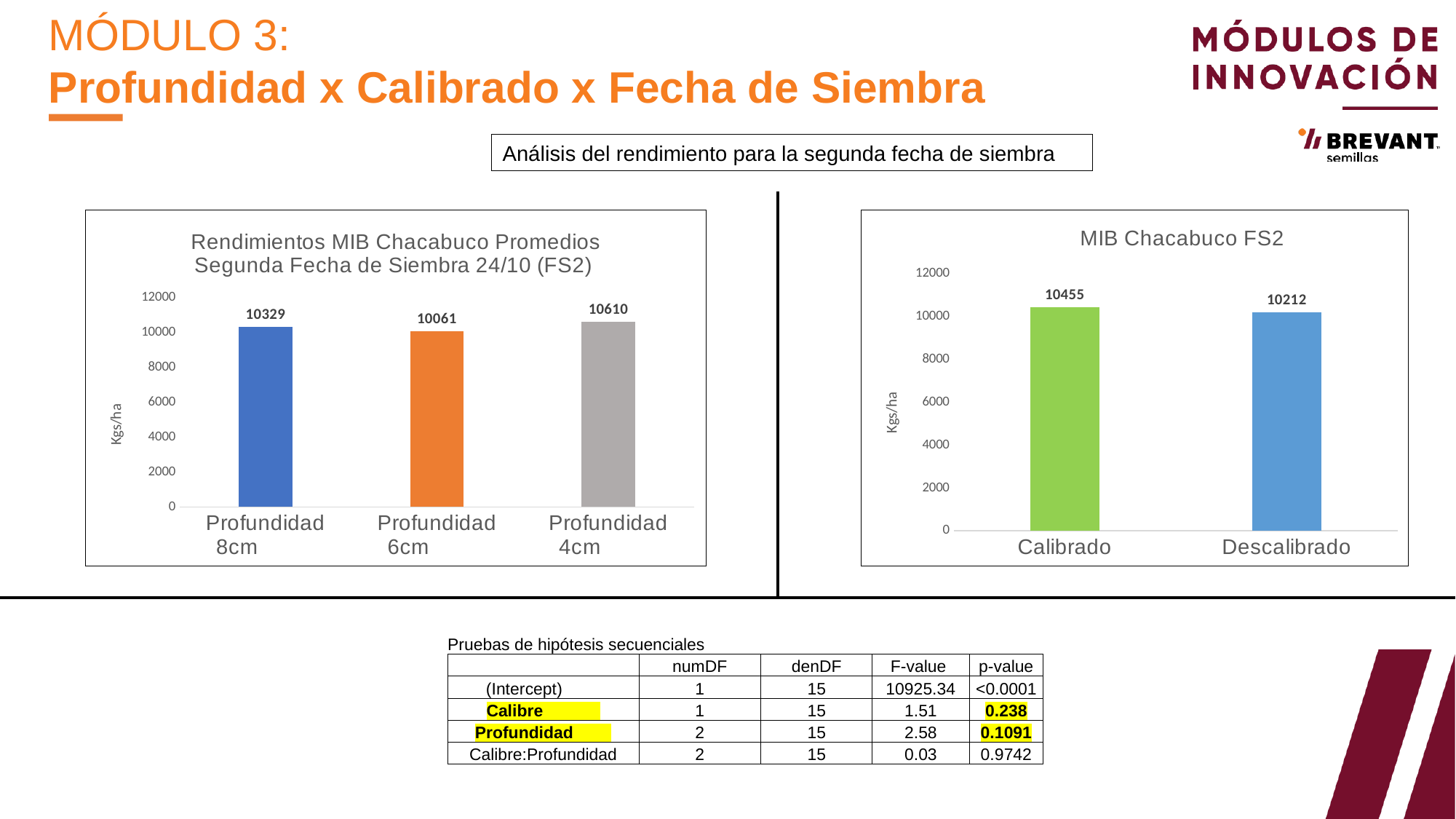
In the left chart (Rendimientos MIB Chacabuco Promedios Segunda Fecha de Siembra 24/10 (FS2)), which category has the highest value? Profundidad 4cm In the left chart (Rendimientos MIB Chacabuco Promedios Segunda Fecha de Siembra 24/10 (FS2)), how many categories are plotted? 3 In the right chart (MIB Chacabuco FS2), what is the value for Descalibrado? 10212 In the left chart (Rendimientos MIB Chacabuco Promedios Segunda Fecha de Siembra 24/10 (FS2)), what is the value for Profundidad 8cm? 10329 In the left chart (Rendimientos MIB Chacabuco Promedios Segunda Fecha de Siembra 24/10 (FS2)), what is the difference between Profundidad 4cm and Profundidad 6cm? 549 In the right chart (MIB Chacabuco FS2), what is the difference between Calibrado and Descalibrado? 243 What is the y-axis label of the left chart (Rendimientos MIB Chacabuco Promedios Segunda Fecha de Siembra 24/10 (FS2))? Kgs/ha In the right chart (MIB Chacabuco FS2), which is larger, Calibrado or Descalibrado? Calibrado In the left chart (Rendimientos MIB Chacabuco Promedios Segunda Fecha de Siembra 24/10 (FS2)), which category has the lowest value? Profundidad 6cm In the left chart (Rendimientos MIB Chacabuco Promedios Segunda Fecha de Siembra 24/10 (FS2)), what is the value for Profundidad 6cm? 10061 What kind of chart is the right chart (MIB Chacabuco FS2)? Bar chart In the right chart (MIB Chacabuco FS2), what is the value for Calibrado? 10455